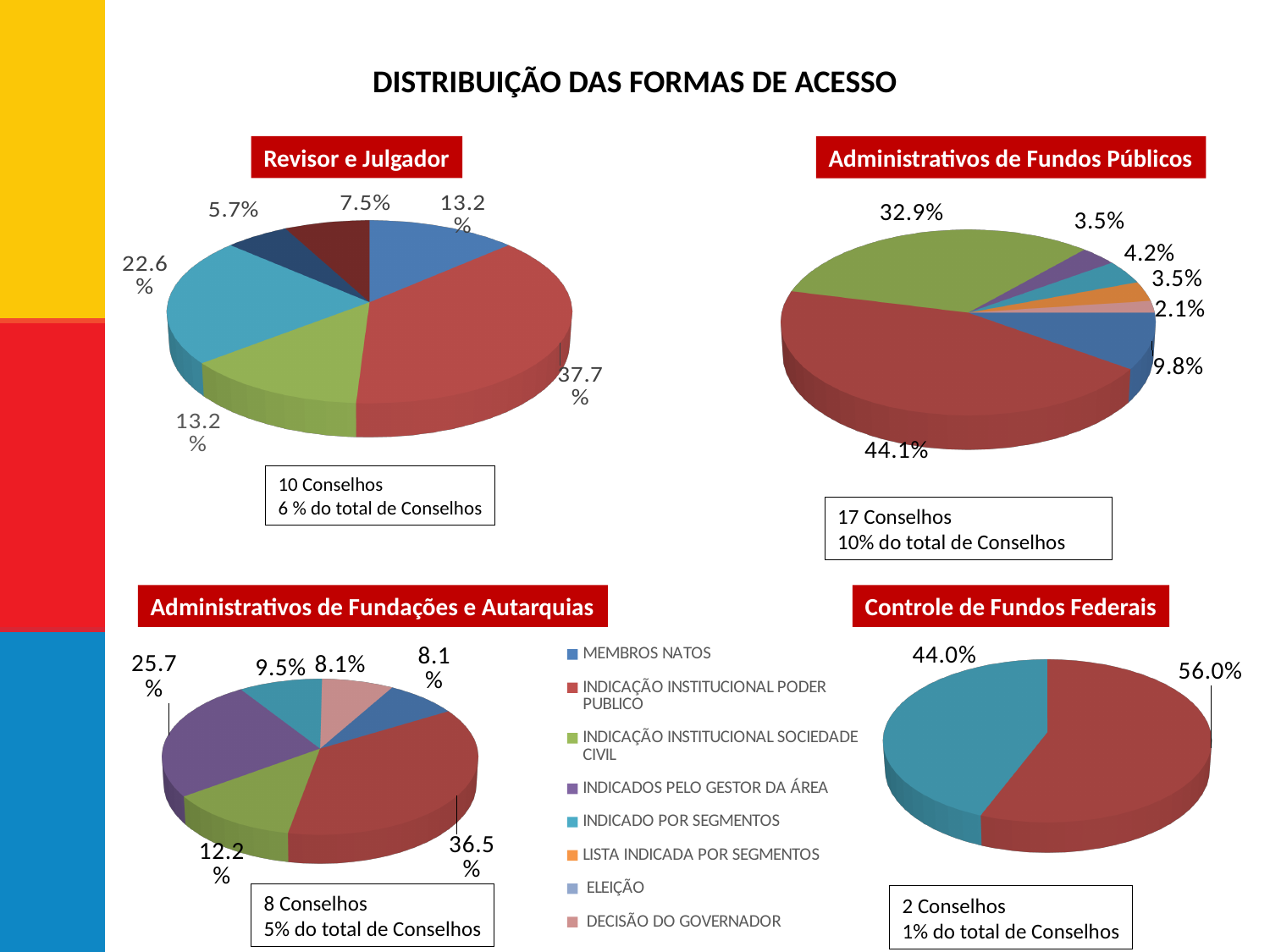
In the 'Controle de Fundos Federais' chart, what is the difference between the two slices (56.0% and 44.0%)? 12.0% How many slices does the 'Revisor e Julgador' pie chart have? 6 In the 'Controle de Fundos Federais' chart, what is the value of the largest slice? 56.0% In the 'Administrativos de Fundos Públicos' chart, what is the share for INDICAÇÃO INSTITUCIONAL PODER PUBLICO? 44.1% In the 'Administrativos de Fundações e Autarquias' chart, which is larger: INDICADOS PELO GESTOR DA ÁREA or INDICAÇÃO INSTITUCIONAL SOCIEDADE CIVIL? INDICADOS PELO GESTOR DA ÁREA In the 'Administrativos de Fundações e Autarquias' chart, what is the value of the largest slice? 36.5% In the 'Administrativos de Fundos Públicos' chart, what is the value of the smallest slice? 2.1% What kind of chart is used for 'Controle de Fundos Federais'? pie chart How many entries does the shared legend list? 8 In the 'Revisor e Julgador' chart, what is the value of the largest slice? 37.7% How many slices does the 'Administrativos de Fundos Públicos' pie chart have? 7